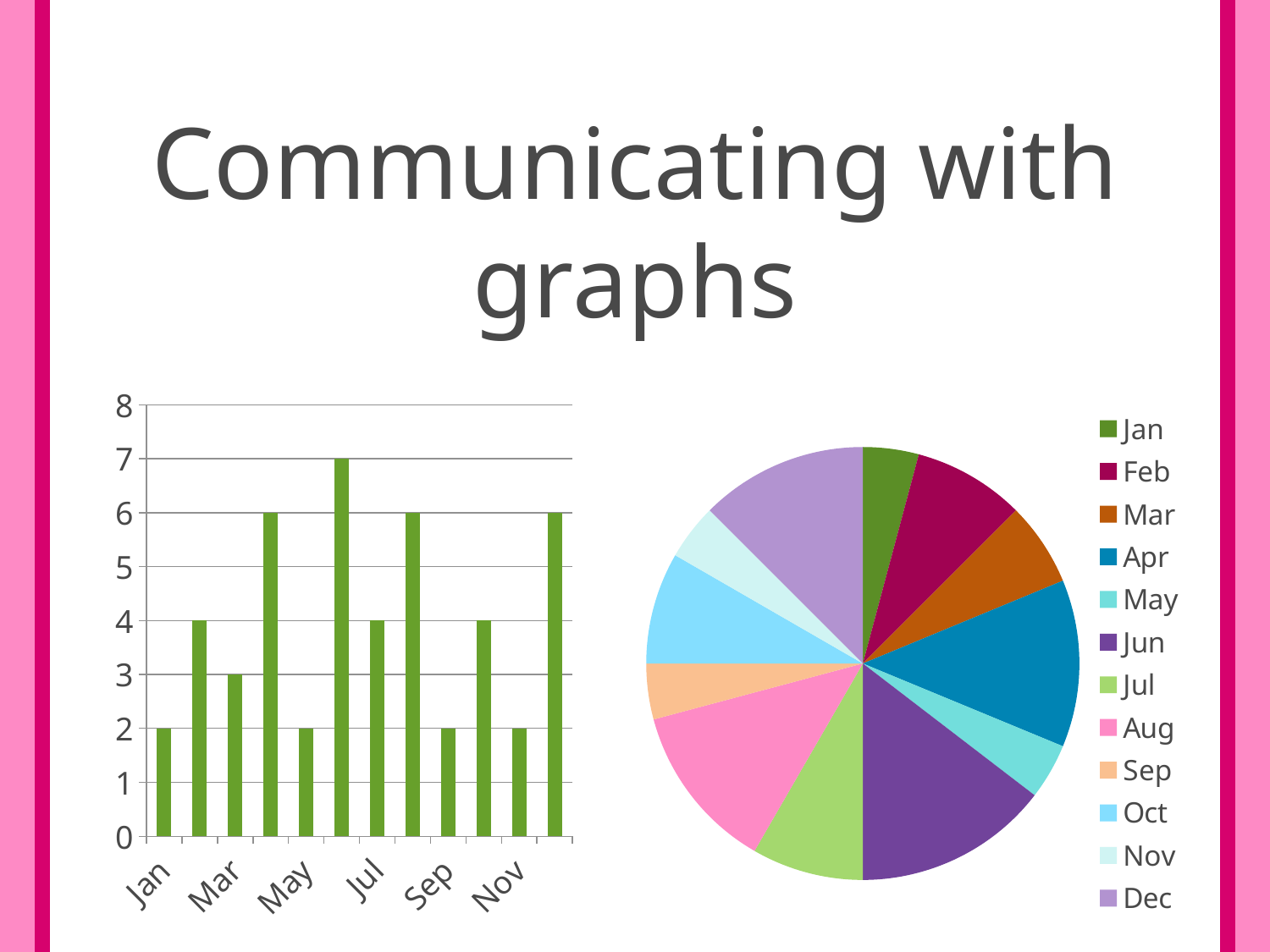
On the bar chart on the left, what is the value for Jul? 4 On the pie chart on the right, which slice is larger, Jun or Jan? Jun On the bar chart on the left, what is the value for Sep? 2 What kind of chart is on the left of the slide? bar chart On the bar chart on the left, how many bars are plotted? 12 On the bar chart on the left, what is the value for Jan? 2 What kind of chart is on the right of the slide? pie chart On the bar chart on the left, what is the value for Mar? 3 On the pie chart on the right, how many entries does the legend list? 12 On the bar chart on the left, which is larger, the value for Jul or the value for Nov? Jul On the bar chart on the left, is the value for Jul greater or less than 3? greater On the bar chart on the left, what is the difference between the values for Jul and Mar? 1